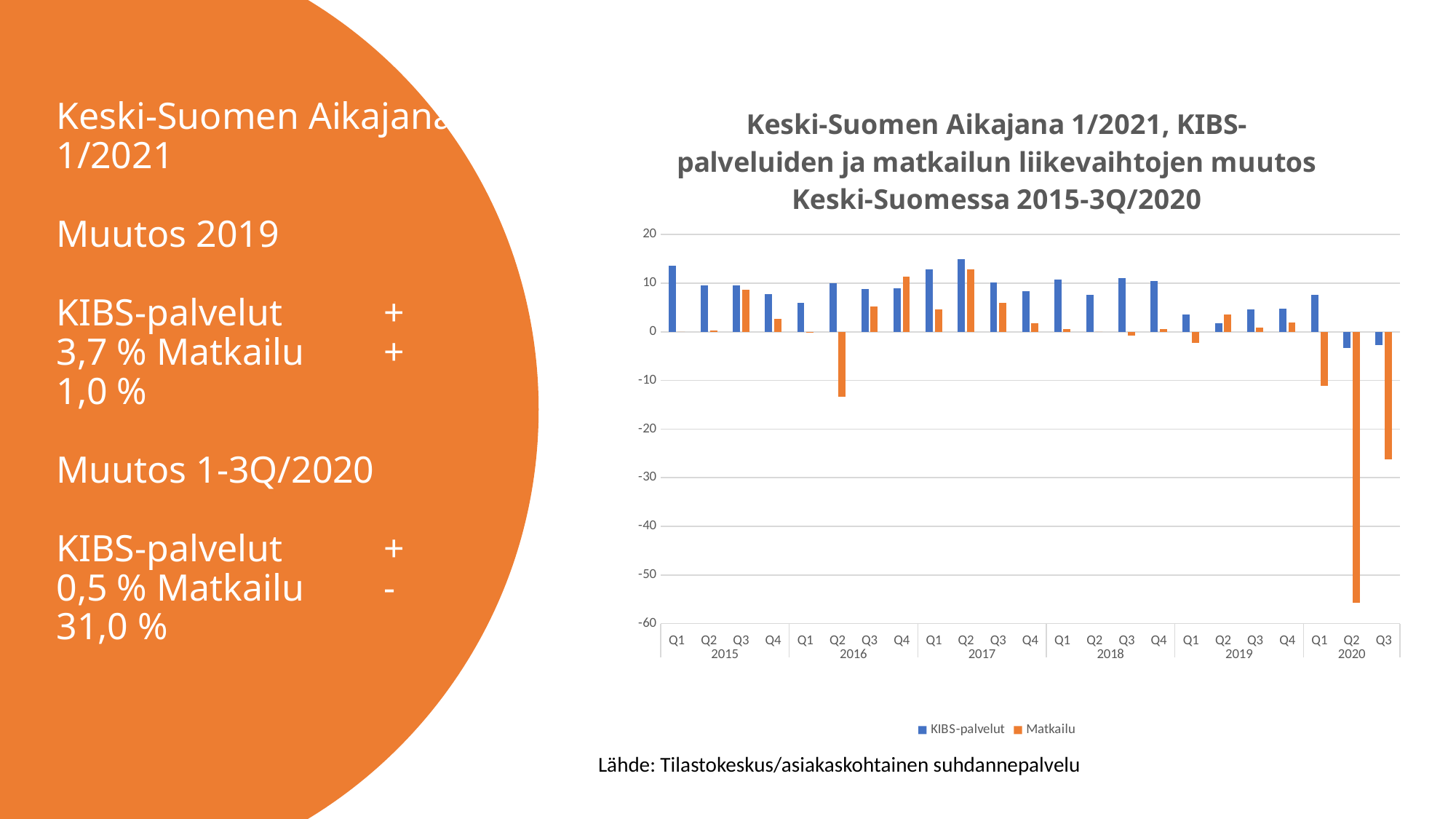
What kind of chart is shown on the slide? bar chart How many series does the chart legend list? 2 How many quarters are plotted on the x axis of the chart? 23 Which series is shown in orange in the chart? Matkailu In which quarter does the Matkailu series reach its lowest value? Q2 2020 Is the Matkailu value for Q2 2020 greater or less than -50? less In Q4 2016, which series has the larger value, KIBS-palvelut or Matkailu? Matkailu Is the KIBS-palvelut value for Q1 2015 greater or less than 10? greater Is the Matkailu value for Q2 2016 greater or less than -10? less In which quarter does the KIBS-palvelut series reach its highest value? Q2 2017 In Q1 2015, which series has the larger value, KIBS-palvelut or Matkailu? KIBS-palvelut